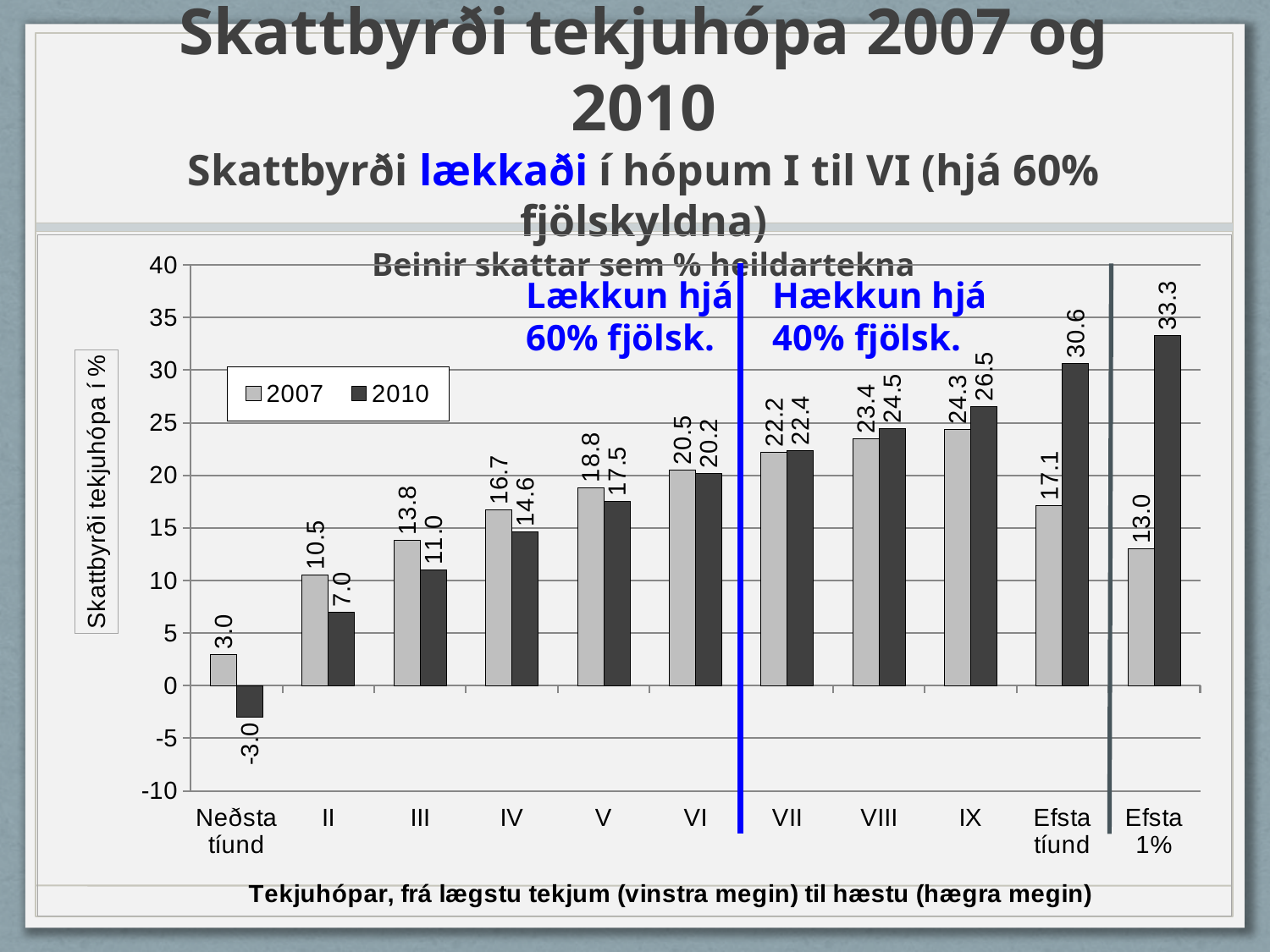
What kind of chart is shown on the slide? bar chart Which category has the highest 2010 value? Efsta 1% What is the difference between the 2010 and 2007 values for Efsta tíund? 13.5 How many series does the legend list? 2 What is the 2007 value for Neðsta tíund? 3.0 Which category has the lowest 2007 value? Neðsta tíund How many categories are shown on the x axis? 11 What is the 2007 value for group IX? 24.3 What is the 2010 value for Efsta 1%? 33.3 Which is larger for group III, the 2007 value or the 2010 value? 2007 What is the label of the y axis? Skattbyrði tekjuhópa í % What is the 2010 value for Neðsta tíund? -3.0